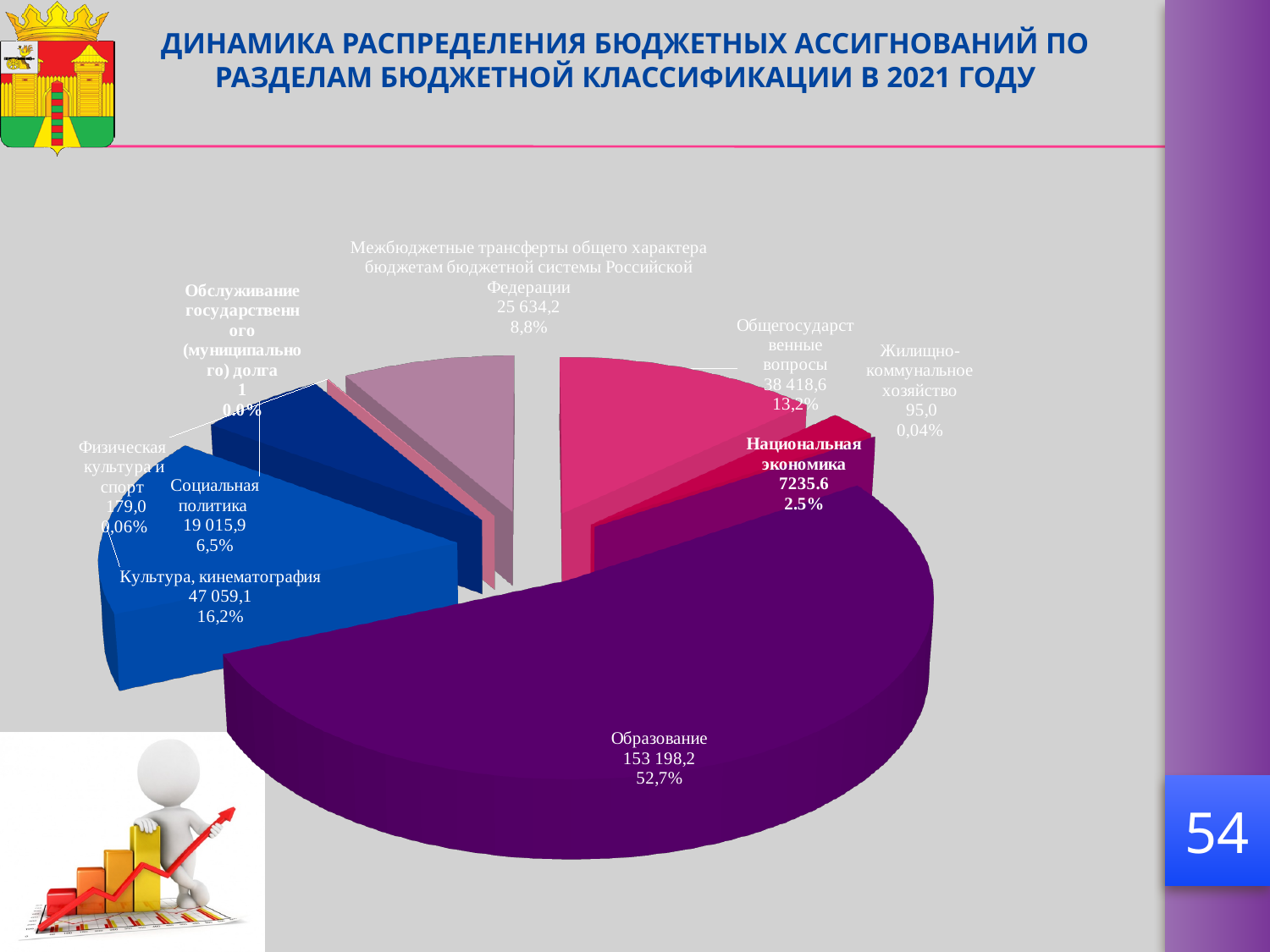
Which section has the largest share of the pie chart? Образование What is the value shown for Культура, кинематография? 47 059,1 What kind of chart is shown on the slide? Pie chart What is the value shown for Социальная политика? 19 015,9 What is the difference between the value for Общегосударственные вопросы and the value for Межбюджетные трансферты общего характера бюджетам бюджетной системы Российской Федерации? 12 784,4 What share of the pie does Образование account for? 52,7% How many sections (categories) are shown in the pie chart? 9 What is the difference in percentage points between the share of Образование and the share of Культура, кинематография? 36,5% What is the value shown for Образование? 153 198,2 Which section has the smallest share of the pie chart? Обслуживание государственного (муниципального) долга Which is larger: the value for Общегосударственные вопросы or the value for Межбюджетные трансферты общего характера бюджетам бюджетной системы Российской Федерации? Общегосударственные вопросы What percentage is shown for Общегосударственные вопросы? 13,2%